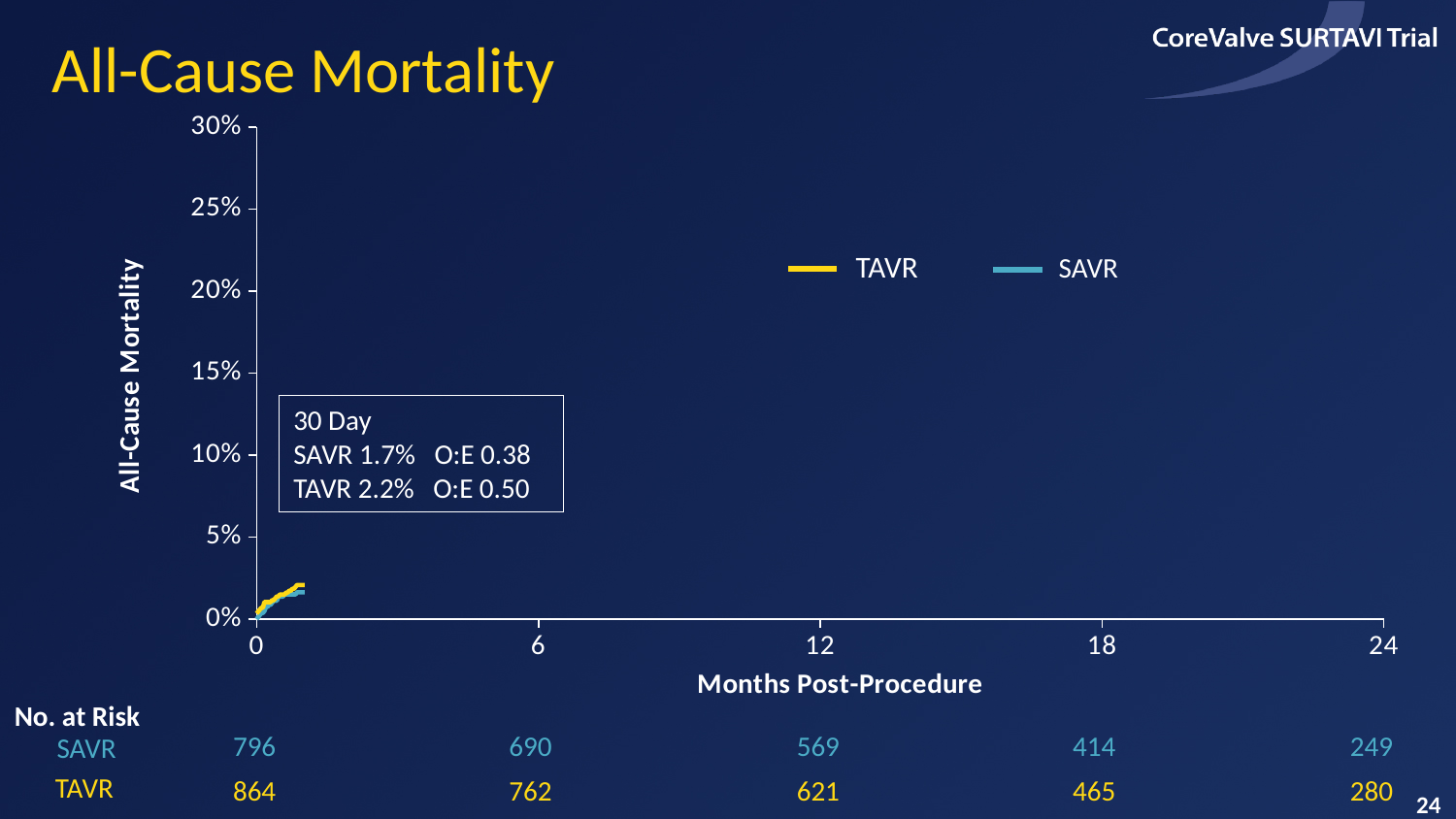
What is the 30-day all-cause mortality for SAVR shown in the annotation box? 1.7% How many series does the legend list? 2 What is the O:E ratio for TAVR at 30 days? 0.50 What is the label of the x axis? Months Post-Procedure How many TAVR patients are at risk at 24 months? 280 What type of chart is shown on the slide? line chart What is the 30-day all-cause mortality for TAVR shown in the annotation box? 2.2% What is the difference between the 30-day all-cause mortality of TAVR and SAVR? 0.5% What is the O:E ratio for SAVR at 30 days? 0.38 What is the title of the chart? All-Cause Mortality How many SAVR patients are at risk at 0 months? 796 Which group has the higher 30-day all-cause mortality, SAVR or TAVR? TAVR